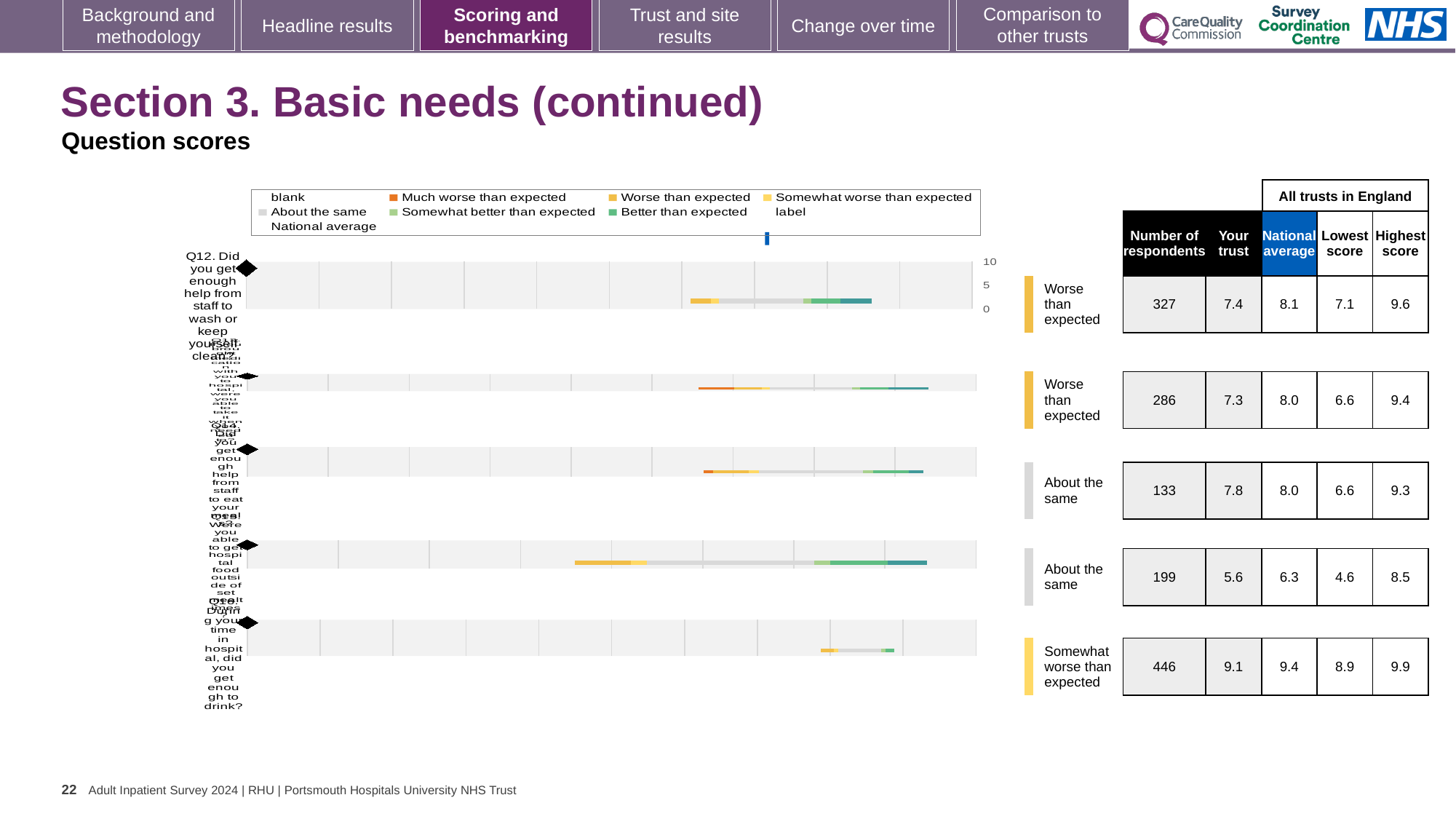
What benchmark category is given for the bottom row? Somewhat worse than expected In the table, what is the national average for the bottom row? 9.4 In the table, what is the 'Your trust' score for the top row (Q12)? 7.4 What colour does the legend use for 'Much worse than expected'? orange What kind of chart is shown on the slide? bar chart In the table, what is the number of respondents for the top row (Q12)? 327 Is the 'Your trust' score for the top row (Q12) larger or smaller than its national average? smaller In the table, what is the difference between the national average and the 'Your trust' score for the top row (Q12)? 0.7 How many question rows (bars) does the chart show? 5 Which question is shown in the top row of the chart? Q12. Did you get enough help from staff to wash or keep yourself clean? In the table, which row has the highest number of respondents? the bottom row (446) In the table, which row has the lowest 'Your trust' score? the fourth row (5.6)